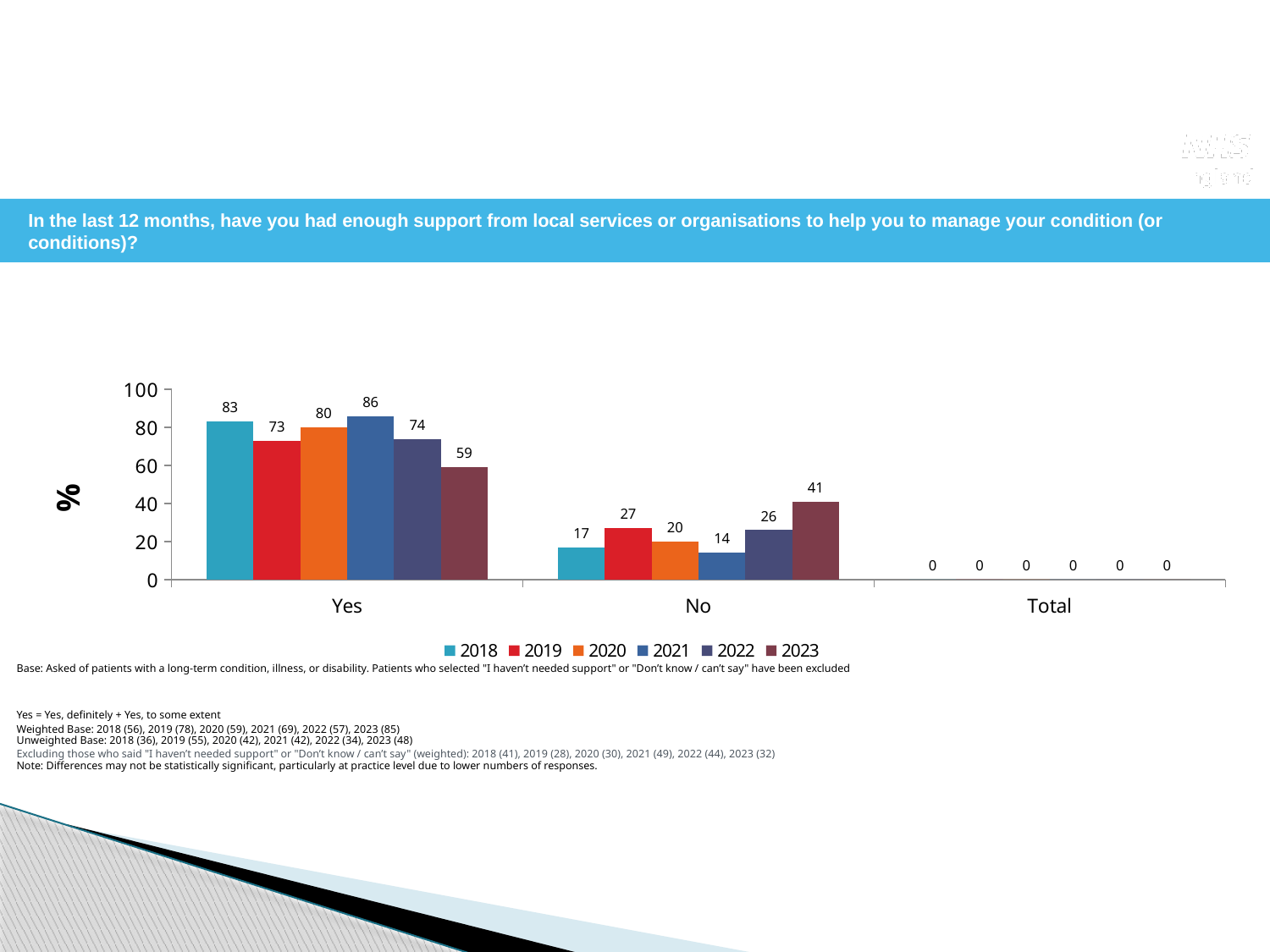
Which year has the lowest value in the No category? 2021 What is the value for 2023 in the Total category? 0 What kind of chart is shown on the slide? Bar chart What is the value for 2018 in the Yes category? 83 What is the difference between the 2021 and 2023 values in the Yes category? 27 Which year has the highest value in the Yes category? 2021 What is the value for 2023 in the Yes category? 59 Which is larger: the 2019 value for No or the 2022 value for No? 2019 What label is shown on the y axis? % How many series does the legend list? 6 How many categories are shown on the x axis? 3 What is the value for 2021 in the No category? 14